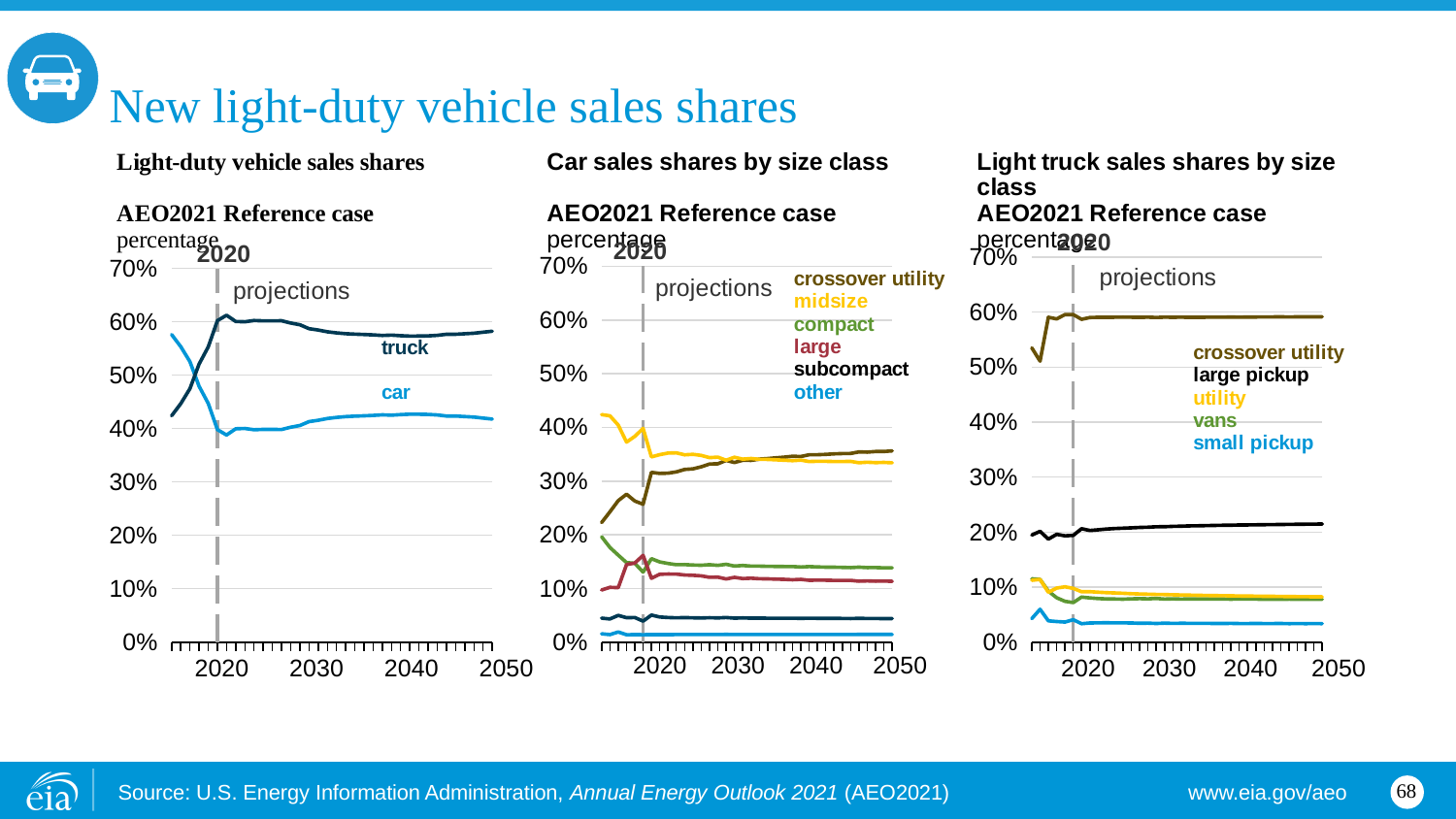
How many series does the legend of the 'Car sales shares by size class' chart list? 6 In the 'Light-duty vehicle sales shares' chart, which series has the higher value in 2050, truck or car? truck In the 'Light truck sales shares by size class' chart, which series has the highest value in 2050? crossover utility In the 'Car sales shares by size class' chart, is the value for other in 2050 greater or less than 10%? less In the 'Car sales shares by size class' chart, is the value for crossover utility in 2050 greater or less than 30%? greater What kind of chart is the 'Light-duty vehicle sales shares' chart? line chart How many series does the legend of the 'Light truck sales shares by size class' chart list? 5 In the 'Car sales shares by size class' chart, does the midsize share rise or fall from 2015 to 2050? fall In the 'Light truck sales shares by size class' chart, which series has the larger value in 2050, large pickup or vans? large pickup In the 'Light-duty vehicle sales shares' chart, is the value for car in 2050 greater or less than 50%? less In the 'Light-duty vehicle sales shares' chart, does the car share rise or fall between 2015 and 2020? fall